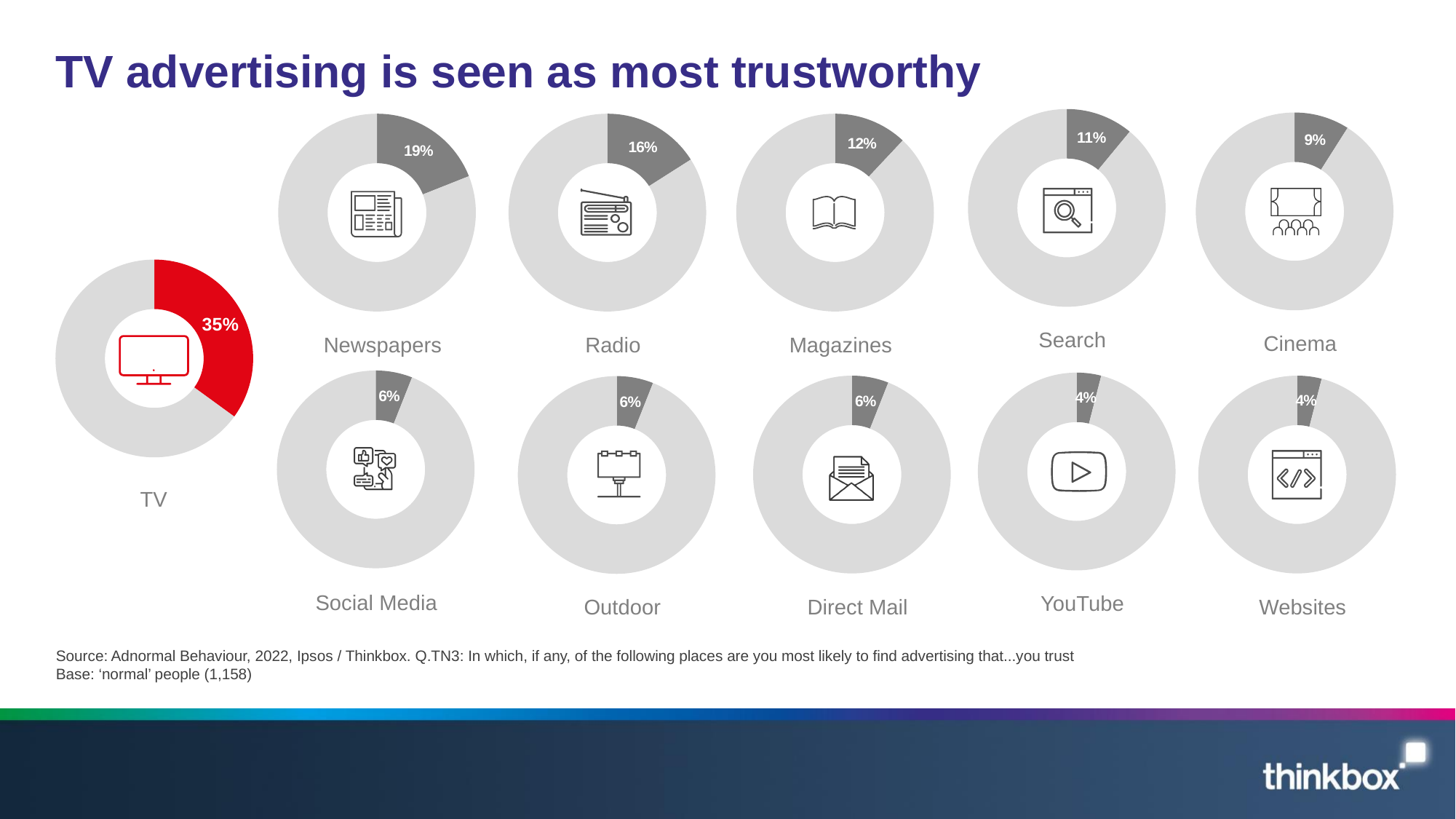
What percentage is shown for Radio? 16% What percentage is shown for Newspapers? 19% Which medium's chart is highlighted in red? TV What percentage is shown for TV? 35% What is the difference in percentage points between Magazines and Search? 1 What is the difference in percentage points between TV and Newspapers? 16 Which medium has the highest percentage on the slide? TV Which has a higher percentage, Cinema or YouTube? Cinema How many media categories are shown on the slide? 11 What kind of chart is used for each medium on the slide? Donut (pie) chart Which has a higher percentage, Radio or Magazines? Radio What percentage is shown for Cinema? 9%